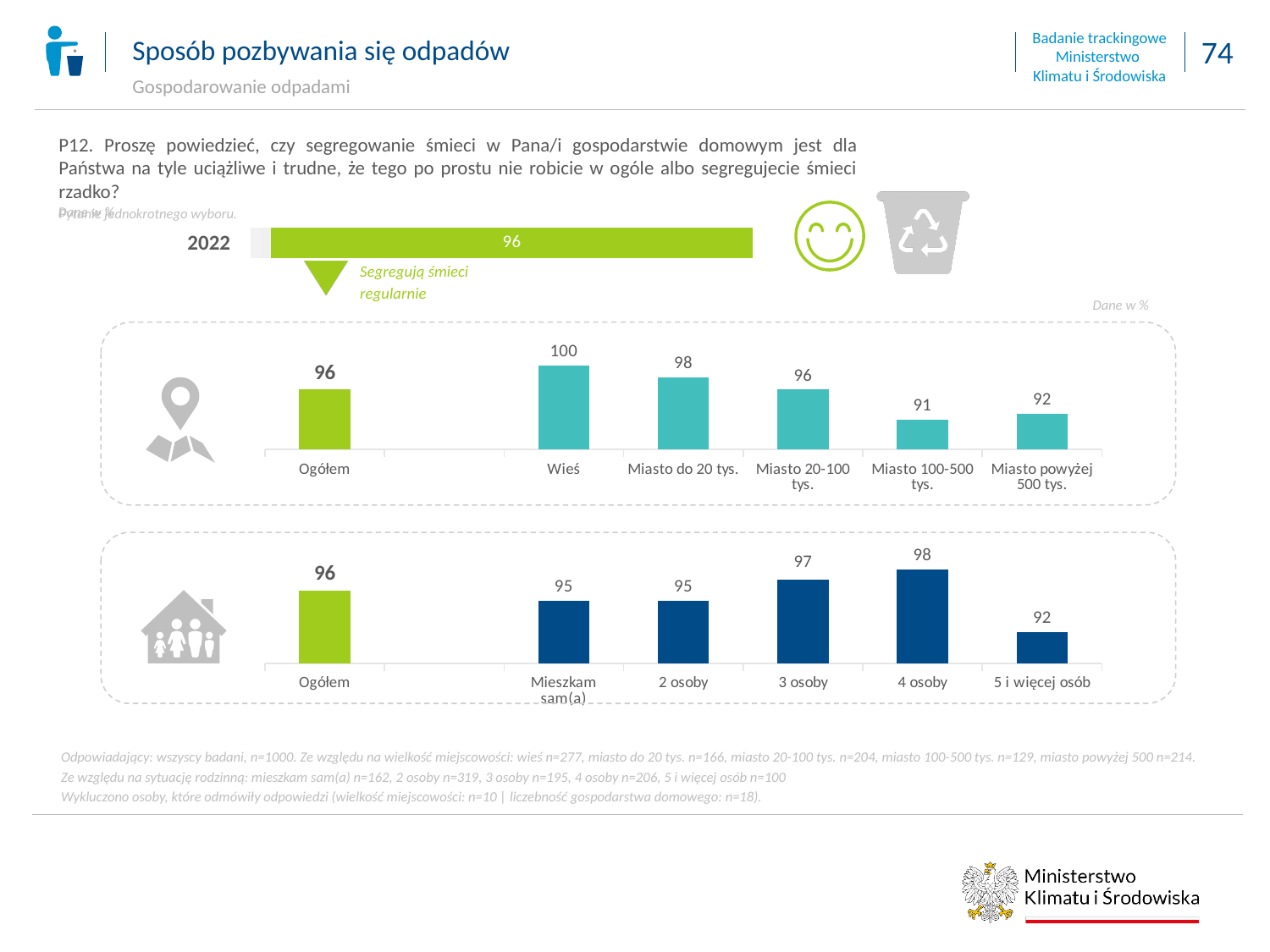
In the middle chart (by locality size), what is the value for Miasto 100-500 tys.? 91 In the bottom chart (by household size), which category has the highest value? 4 osoby In the middle chart (by locality size), what is the difference between Wieś and Miasto powyżej 500 tys.? 8 What type of chart is the middle chart (by locality size)? Bar chart In the middle chart (by locality size), which category has the highest value? Wieś In the bottom chart (by household size), how many categories are shown including Ogółem? 6 In the top bar chart labelled 2022, what value is shown for Segregują śmieci regularnie? 96 In the bottom chart (by household size), what is the value for 4 osoby? 98 In the bottom chart (by household size), which is larger: 3 osoby or Mieszkam sam(a)? 3 osoby In the middle chart (by locality size), what is the value for Wieś? 100 In the middle chart (by locality size), which category has the lowest value? Miasto 100-500 tys. In the bottom chart (by household size), what is the value for 5 i więcej osób? 92